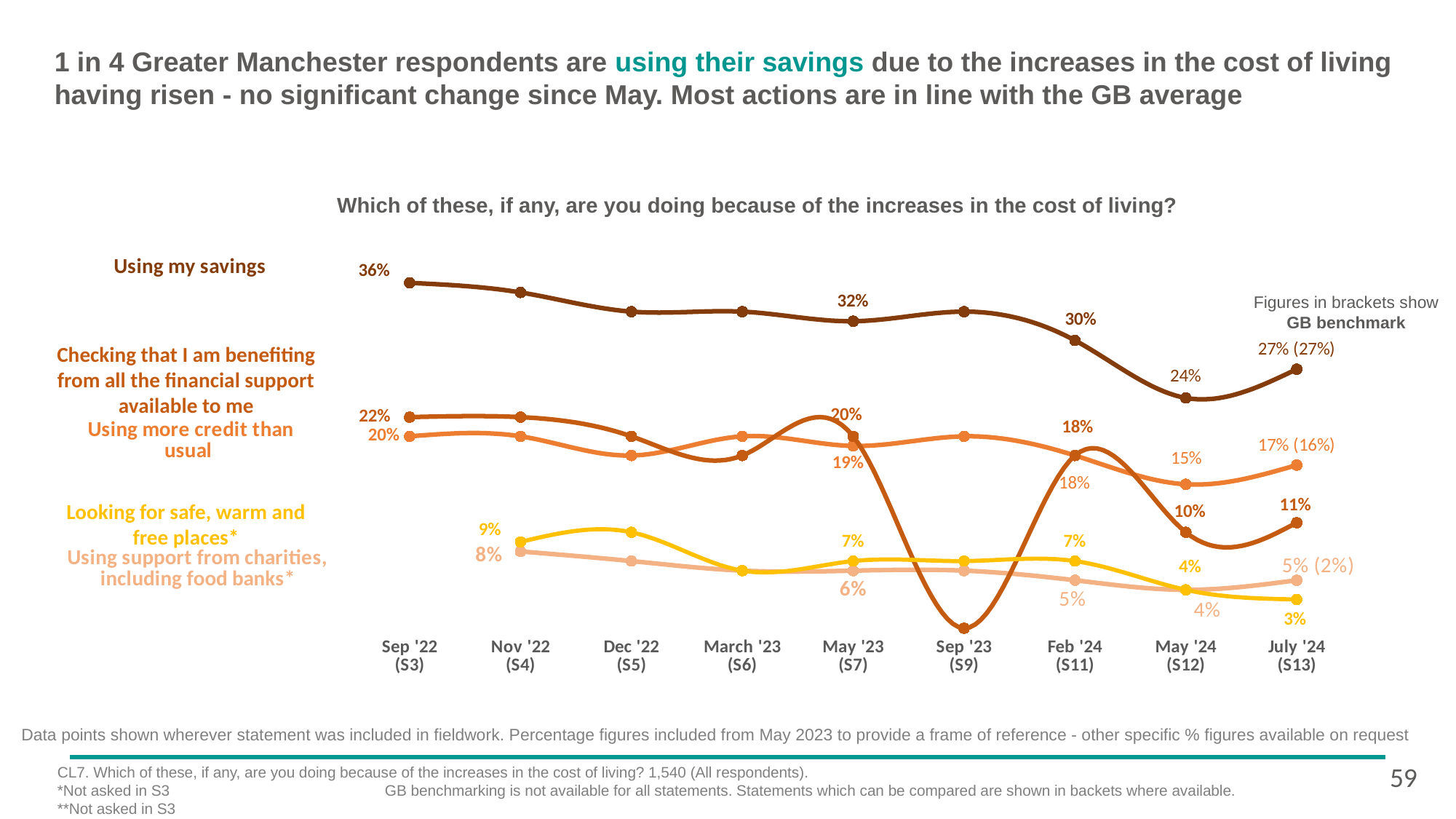
Which action has the lowest value in July '24? Looking for safe, warm and free places What percentage of respondents were 'Using my savings' in Sep '22 (S3)? 36% By how many percentage points did 'Using my savings' fall between Sep '22 (36%) and July '24 (27%)? 9 percentage points In May '24, which is larger: 'Using more credit than usual' or 'Checking that I am benefiting from all the financial support available to me'? Using more credit than usual How many data series (actions) are plotted on the chart? 5 What type of chart is used on this slide? Line chart What is the value for 'Using my savings' in May '24 (S12)? 24% What is the GB benchmark shown in brackets for 'Using more credit than usual' in July '24? 16% What is the value for 'Looking for safe, warm and free places' in Nov '22 (S4)? 9% How many survey waves are shown along the x axis? 9 Which action has the highest value in July '24? Using my savings What is the value for 'Using my savings' in July '24 (S13)? 27%